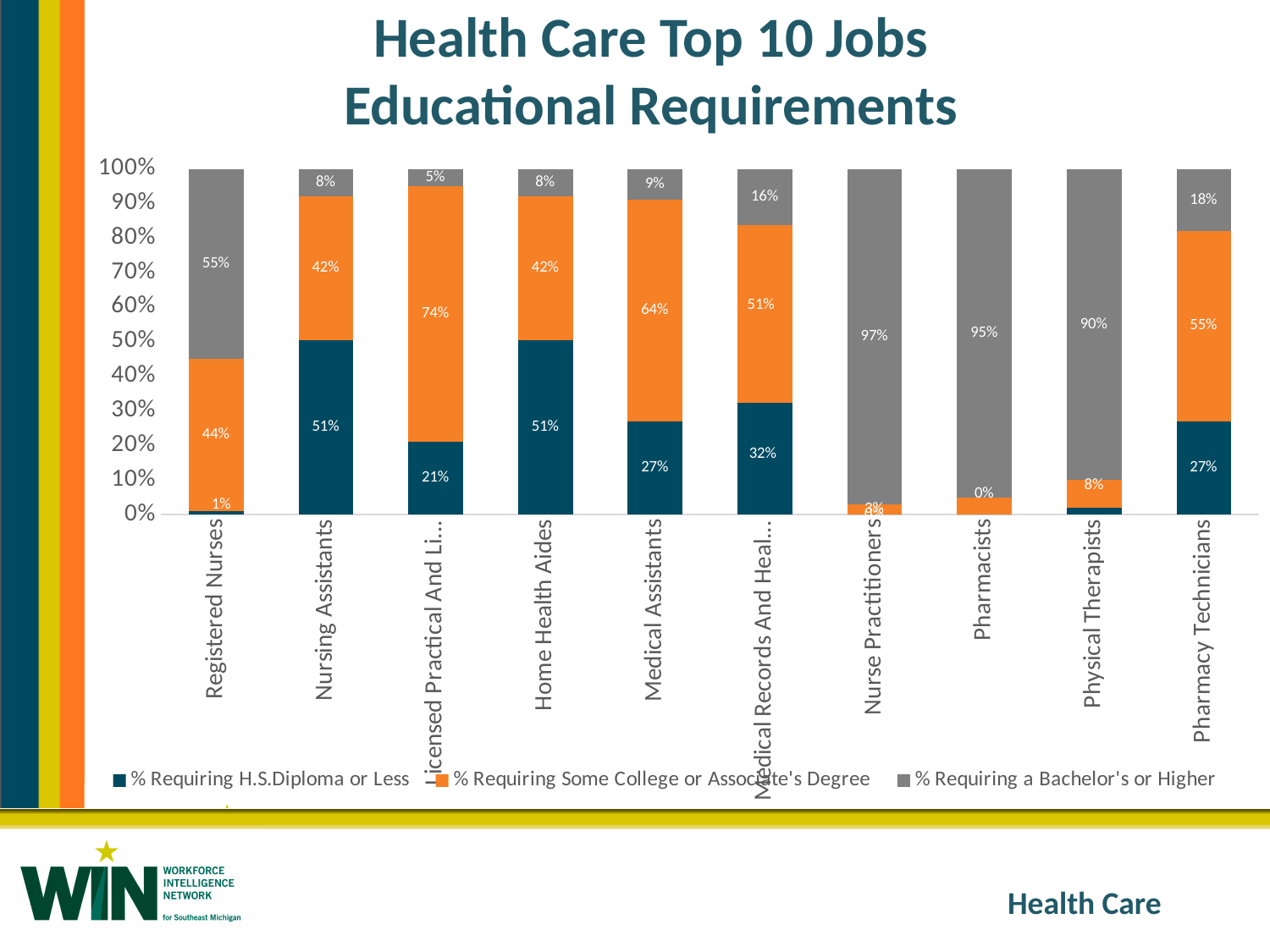
Which is larger: the percentage of Physical Therapists or Pharmacists jobs requiring a Bachelor's or Higher? Pharmacists Which job has the highest percentage requiring Some College or Associate's Degree? Licensed Practical And Li... What is the difference between the percentage of Nursing Assistants and Medical Assistants jobs requiring H.S. Diploma or Less? 24% How many job categories are shown on the x axis? 10 What percentage of Registered Nurses jobs require a Bachelor's or Higher? 55% Which job has the highest percentage requiring a Bachelor's or Higher? Nurse Practitioners Is the percentage of Home Health Aides jobs requiring H.S. Diploma or Less greater or less than 40%? greater What percentage of Pharmacy Technicians jobs require H.S. Diploma or Less? 27% What is the title of the chart? Health Care Top 10 Jobs Educational Requirements How many series does the legend list? 3 What type of chart is shown on the slide? Stacked bar chart What percentage of Medical Assistants jobs require Some College or Associate's Degree? 64%